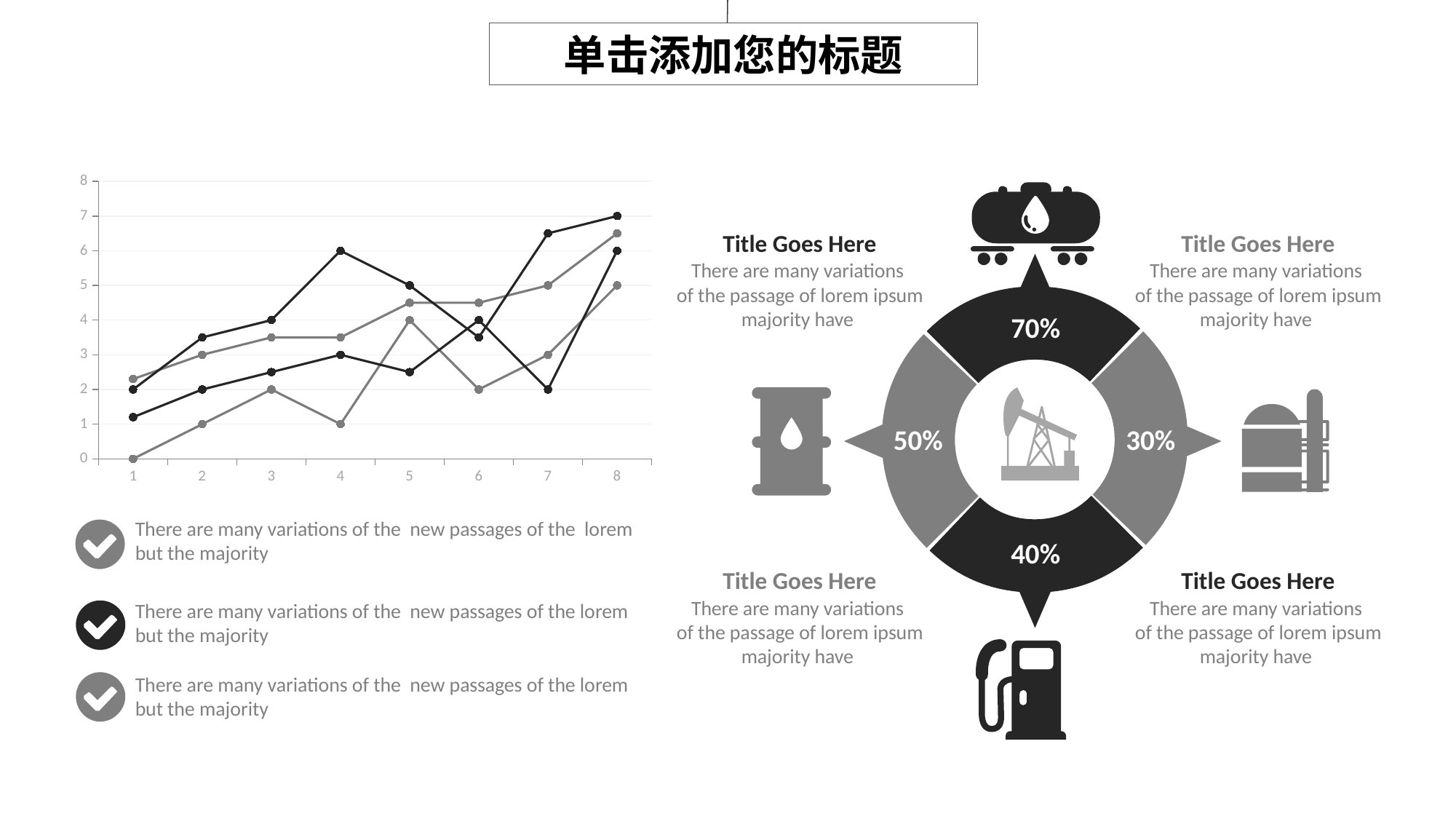
In the line chart on the left, how many lines are plotted? 4 What kind of chart is shown on the left side of the slide? line chart In the ring diagram on the right, which segment shows the largest percentage: the top (70%) or the bottom (40%)? top In the line chart on the left, what is the highest value reached by any line at x = 8? 7 In the line chart on the left, how many points are labelled along the x axis? 8 In the line chart on the left, is the highest value at x = 4 greater or less than 5? greater In the ring diagram on the right, what percentage is shown in the right segment? 30% In the line chart on the left, is the highest value at x = 1 greater or less than 3? less In the line chart on the left, what is the lowest value plotted at x = 1? 0 In the ring diagram on the right, what percentage is shown in the top segment? 70% In the line chart on the left, what is the maximum value shown on the y axis? 8 In the line chart on the left, do the lines generally rise or fall from x = 1 to x = 8? rise